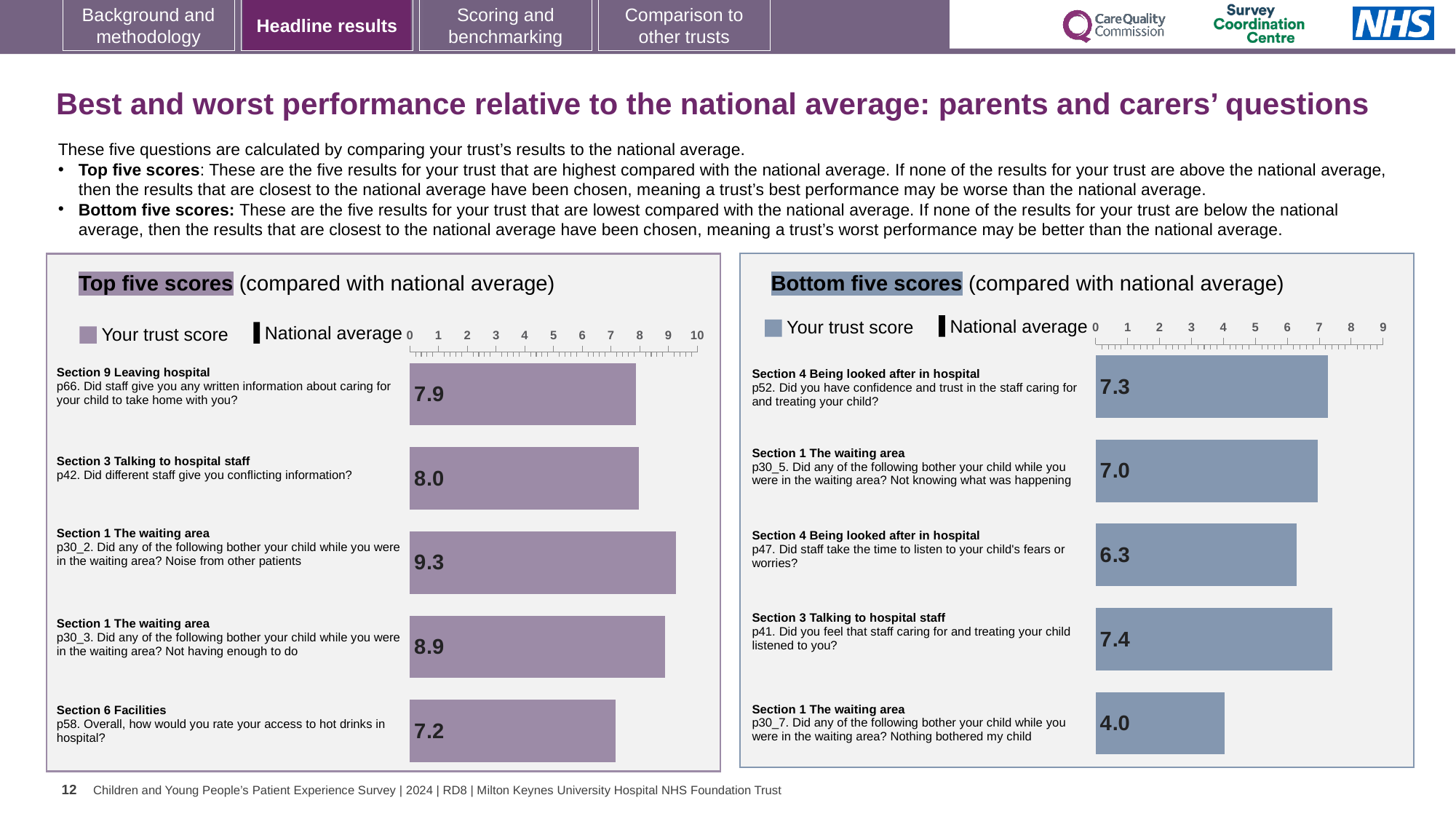
In the Top five scores chart, what is the difference between the trust scores for p30_2 (noise from other patients) and p58 (access to hot drinks)? 2.1 In the Top five scores chart, what is the trust score for p30_3 (not having enough to do in the waiting area)? 8.9 In the Top five scores chart, is the trust score for p42 (conflicting information) greater or less than 5? greater In the Bottom five scores chart, what is the difference between the trust scores for p41 (staff listened to you) and p47 (listen to your child's fears or worries)? 1.1 In the Top five scores chart, which question has the highest trust score? p30_2. Did any of the following bother your child while you were in the waiting area? Noise from other patients In the Bottom five scores chart, what is the trust score for p30_7 (nothing bothered my child)? 4.0 In the Top five scores chart, how many questions are plotted? 5 What kind of chart is used in the Top five scores panel? Bar chart In the Bottom five scores chart, which question has the lowest trust score? p30_7. Did any of the following bother your child while you were in the waiting area? Nothing bothered my child How many entries does the legend of the Bottom five scores chart list? 2 In the Top five scores chart, what is the trust score for p66 (written information about caring for your child to take home)? 7.9 In the Bottom five scores chart, which is larger: the trust score for p52 (confidence and trust in staff) or p41 (staff listened to you)? p41 (7.4)